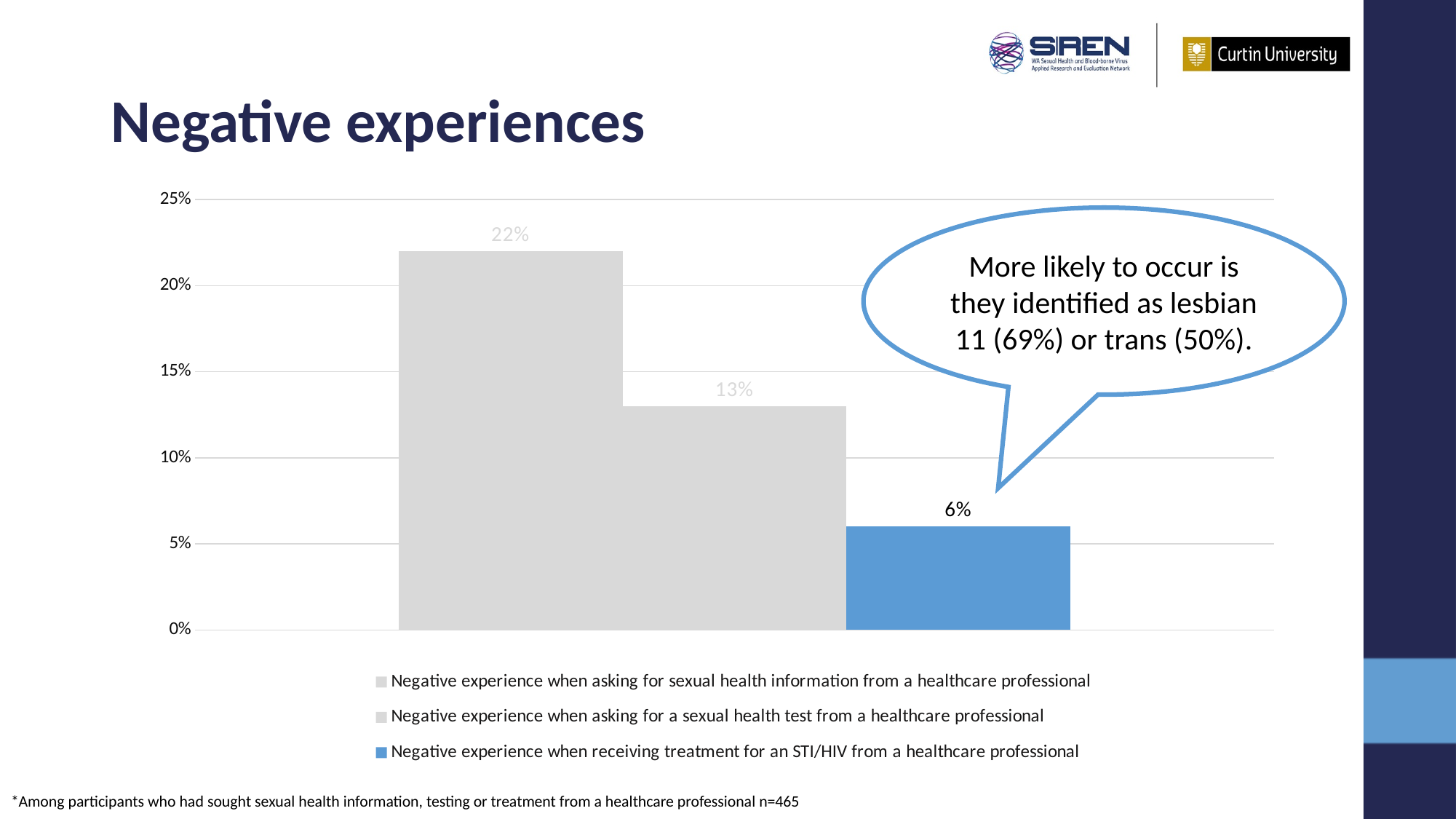
How many series does the legend list? 3 What percentage of participants reported a negative experience when asking for a sexual health test from a healthcare professional? 13% Which type of negative experience has the lowest percentage? Negative experience when receiving treatment for an STI/HIV from a healthcare professional Which is larger: the percentage for negative experiences when asking for a sexual health test or when receiving treatment for an STI/HIV? Negative experience when asking for a sexual health test from a healthcare professional What is the difference in percentage points between negative experiences when asking for a sexual health test and when receiving treatment for an STI/HIV? 7% What kind of chart is shown on the slide? Bar chart What is the title of the slide containing the chart? Negative experiences What percentage of participants reported a negative experience when receiving treatment for an STI/HIV from a healthcare professional? 6% Is the value for negative experience when asking for sexual health information greater or less than 20%? greater What is the difference in percentage points between negative experiences when asking for sexual health information and when asking for a sexual health test? 9% Which type of negative experience has the highest percentage? Negative experience when asking for sexual health information from a healthcare professional What percentage of participants reported a negative experience when asking for sexual health information from a healthcare professional? 22%